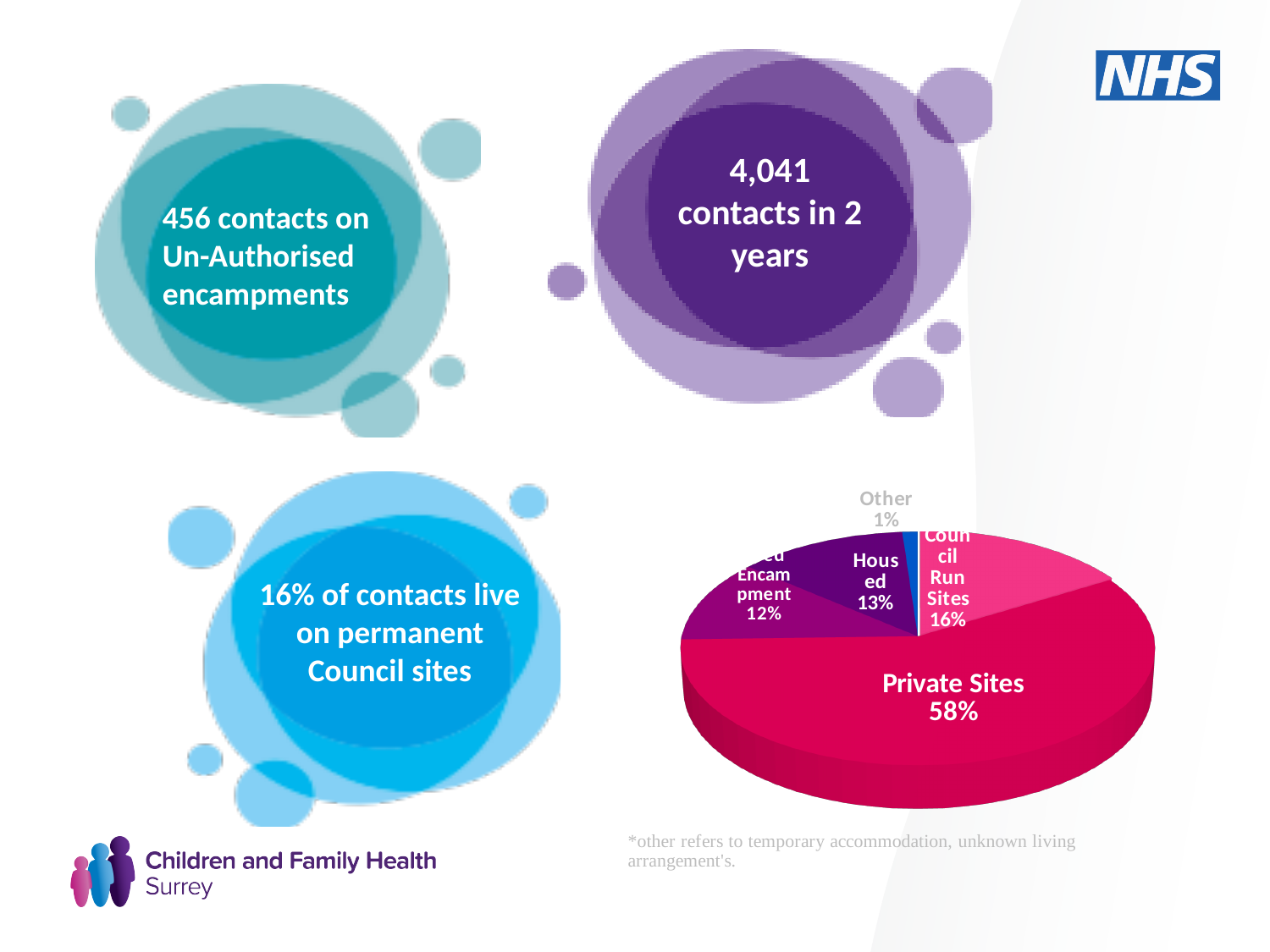
In the pie chart, which is larger: Housed or Council Run Sites? Council Run Sites How many percentage points larger is Private Sites than Council Run Sites in the pie chart? 42 percentage points How many slices does the pie chart have? 5 What percentage of the pie chart is Council Run Sites? 16% Which slice of the pie chart is the largest? Private Sites What percentage of the pie chart is Private Sites? 58% What percentage of the pie chart is Other? 1% Which slice of the pie chart is the smallest? Other What is the difference in percentage points between Housed and Other in the pie chart? 12 percentage points What kind of chart is shown on the slide? Pie chart What percentage of the pie chart is Housed? 13% According to the footnote under the pie chart, what does 'other' refer to? Temporary accommodation, unknown living arrangements